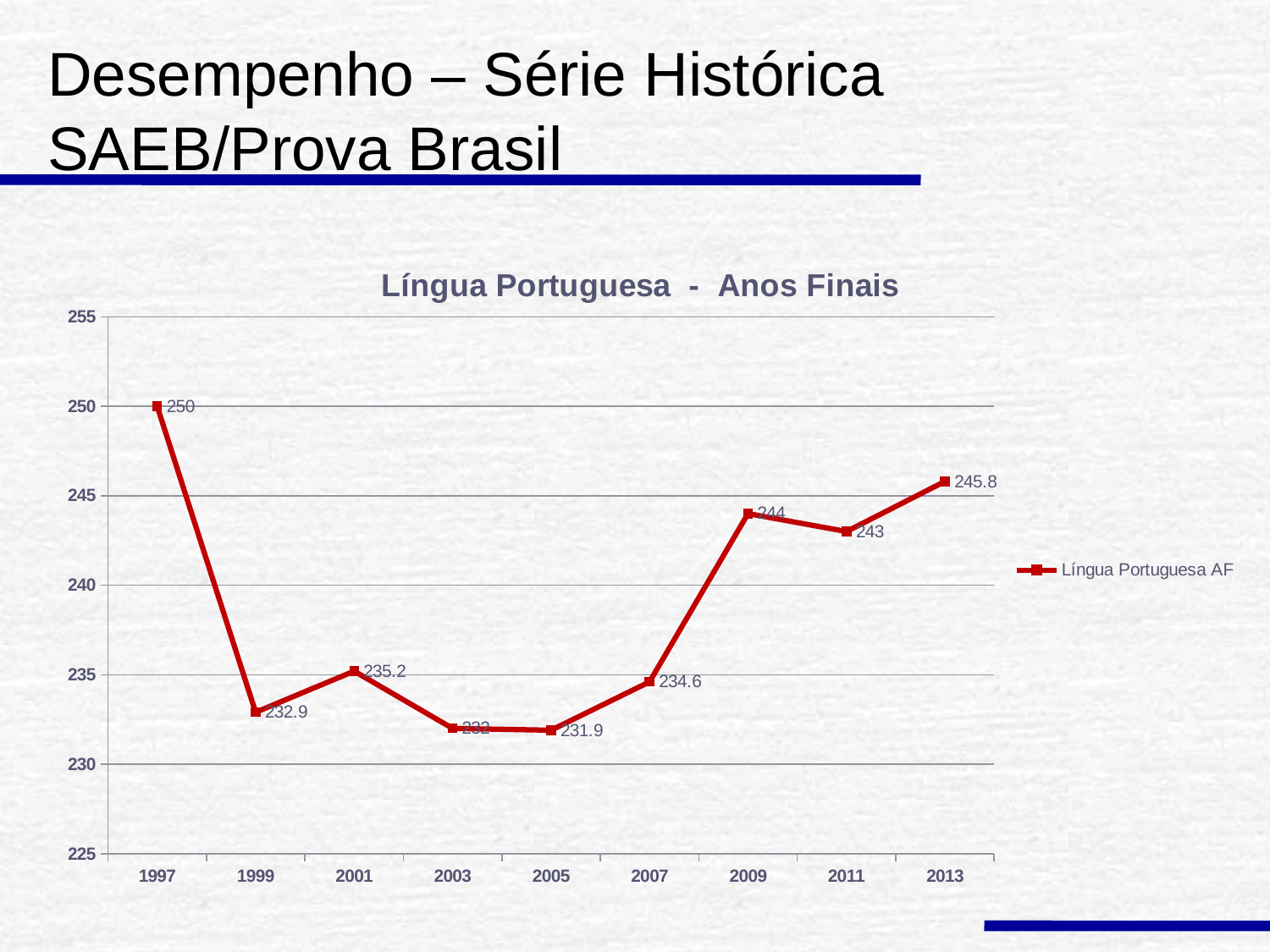
What is the value for 2001? 235.2 How many years are plotted on the x axis? 9 What is the difference between the values for 1997 and 1999? 17.1 What is the value for 2007? 234.6 How many series does the legend list? 1 Which is larger, the value for 2009 or the value for 2011? 2009 What is the value for 2013? 245.8 Which year has the highest value? 1997 What is the difference between the values for 2013 and 2011? 2.8 What is the title of the chart? Língua Portuguesa - Anos Finais What type of chart is shown on the slide? line chart What is the value for 1997? 250